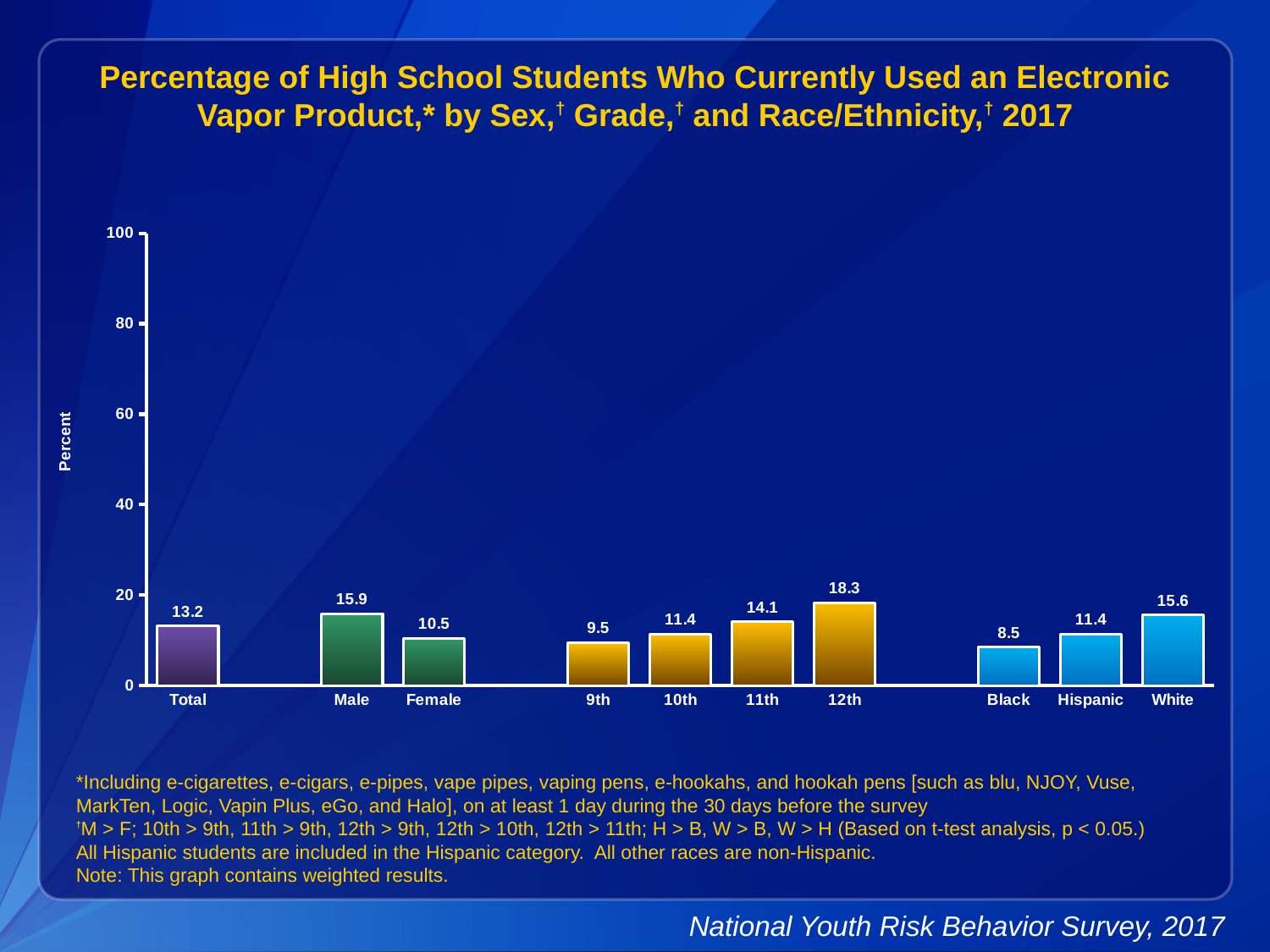
What is the value for Female? 10.5 What is the value for 12th grade? 18.3 Do the values rise or fall from 9th grade to 12th grade? rise Which category has the highest value? 12th What is the value for Black students? 8.5 Which category has the lowest value? Black What kind of chart is this? bar chart How many categories are shown on the x axis? 10 What is the value for Total? 13.2 What is the difference between the Male and Female values? 5.4 Which is larger, the value for White or the value for Hispanic? White Is the value for 12th grade greater or less than 20? less